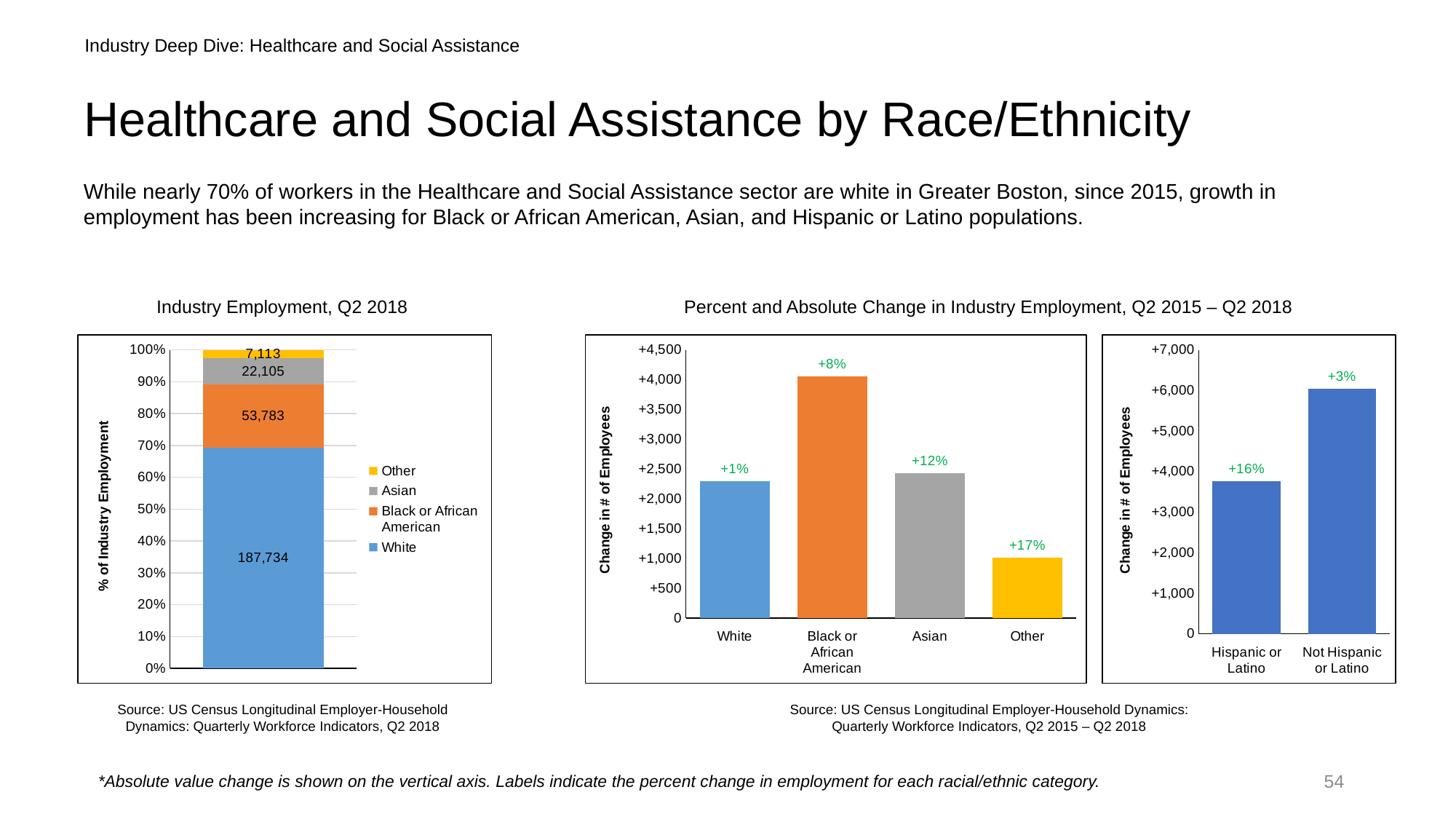
In the 'Industry Employment, Q2 2018' chart, what is the difference between the Black or African American value and the Asian value? 31,678 In the 'Industry Employment, Q2 2018' chart, what is the total of the stacked bar? 270,735 In the middle chart (Percent and Absolute Change in Industry Employment by race), is the absolute change for White greater or less than 2,000? greater In the right chart (Hispanic or Latino vs Not Hispanic or Latino), which category has the larger absolute change in number of employees? Not Hispanic or Latino In the middle chart (Percent and Absolute Change in Industry Employment by race), how many categories are shown on the x axis? 4 In the middle chart (Percent and Absolute Change in Industry Employment by race), which category has the largest absolute change in number of employees? Black or African American In the 'Industry Employment, Q2 2018' chart, what is the value shown for White? 187,734 In the 'Industry Employment, Q2 2018' chart, how many series does the legend list? 4 In the 'Industry Employment, Q2 2018' chart, what is the value shown for Asian? 22,105 In the middle chart (Percent and Absolute Change in Industry Employment by race), what percent change label is shown for Asian? +12% In the right chart (Hispanic or Latino vs Not Hispanic or Latino), what percent change label is shown for Hispanic or Latino? +16% In the 'Industry Employment, Q2 2018' chart, which group has the smallest value? Other